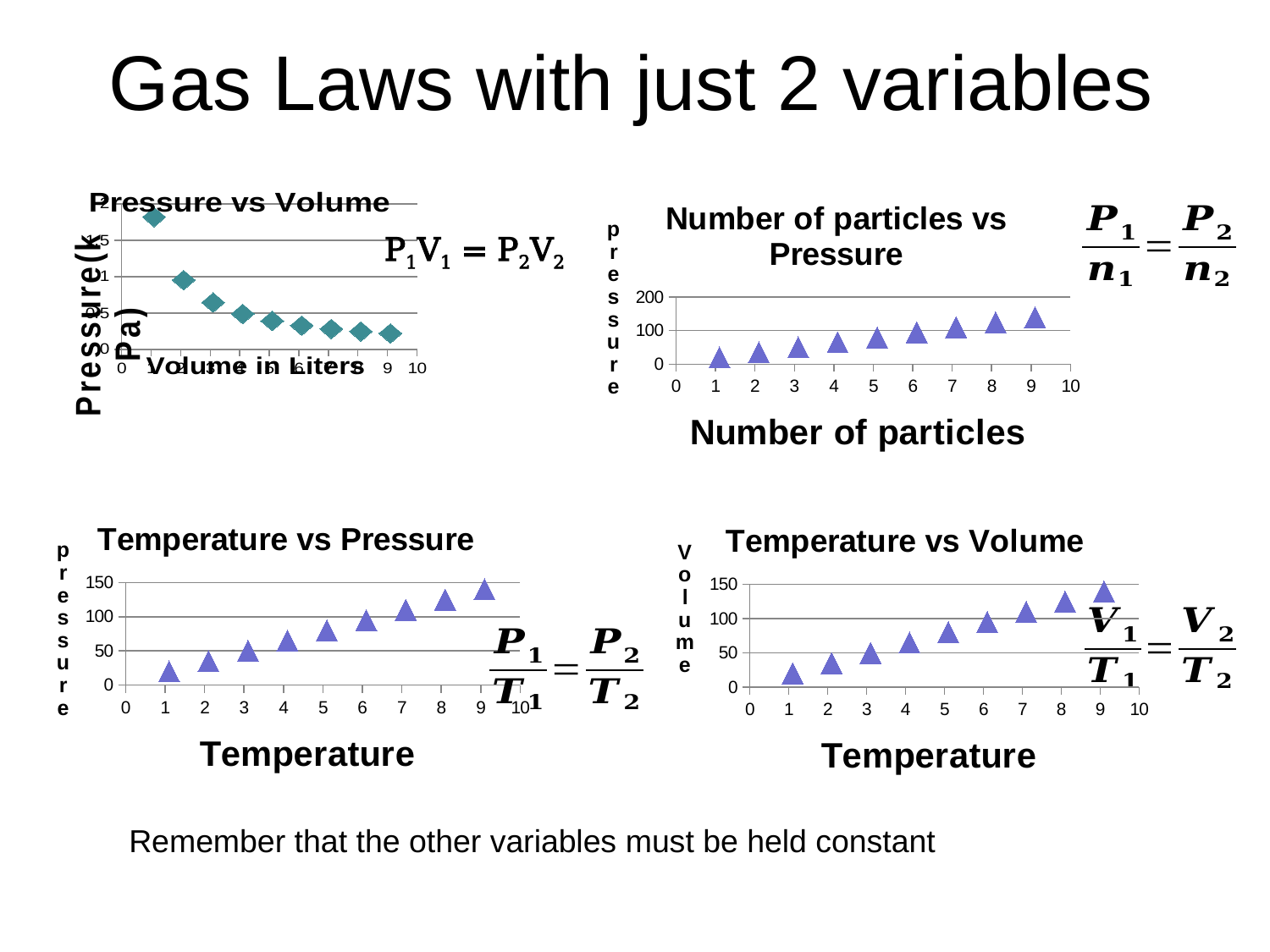
In the "Temperature vs Volume" chart, at which temperature is the volume highest? 9 What kind of chart is the "Temperature vs Pressure" chart? scatter chart In the "Temperature vs Pressure" chart, is the value at temperature 1 greater or less than 50? less In the "Number of particles vs Pressure" chart, is the value at 2 particles greater or less than 100? less In the "Pressure vs Volume" chart, at which volume is the pressure highest? 1 What is the x-axis title of the "Number of particles vs Pressure" chart? Number of particles How many data points are plotted in the "Temperature vs Pressure" chart? 9 In the "Number of particles vs Pressure" chart, do the values rise or fall as the number of particles increases? rise In the "Temperature vs Volume" chart, do the values rise or fall as temperature increases? rise In the "Temperature vs Pressure" chart, is the value at temperature 9 greater or less than 100? greater In the "Pressure vs Volume" chart, do the values rise or fall as volume increases? fall How many data points are plotted in the "Number of particles vs Pressure" chart? 9